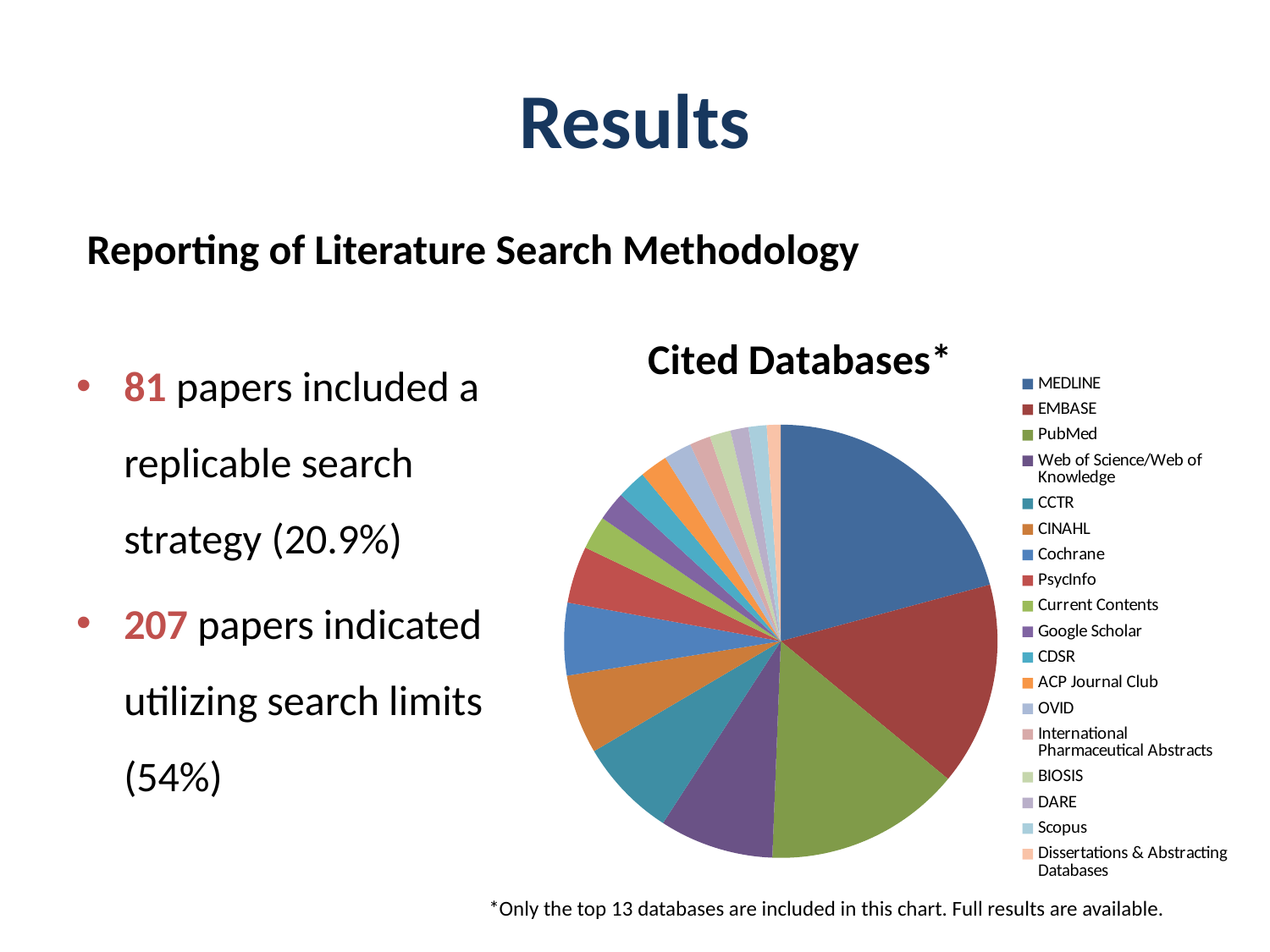
Which slice is larger in the Cited Databases chart, EMBASE or Google Scholar? EMBASE Which slice is larger in the Cited Databases chart, CINAHL or ACP Journal Club? CINAHL What kind of chart is shown on the slide? pie chart Which slice is larger in the Cited Databases chart, MEDLINE or Scopus? MEDLINE What is the first database listed in the chart's legend? MEDLINE Which database has the largest slice in the Cited Databases pie chart? MEDLINE What is the title of the chart? Cited Databases* How many databases are listed in the chart's legend? 18